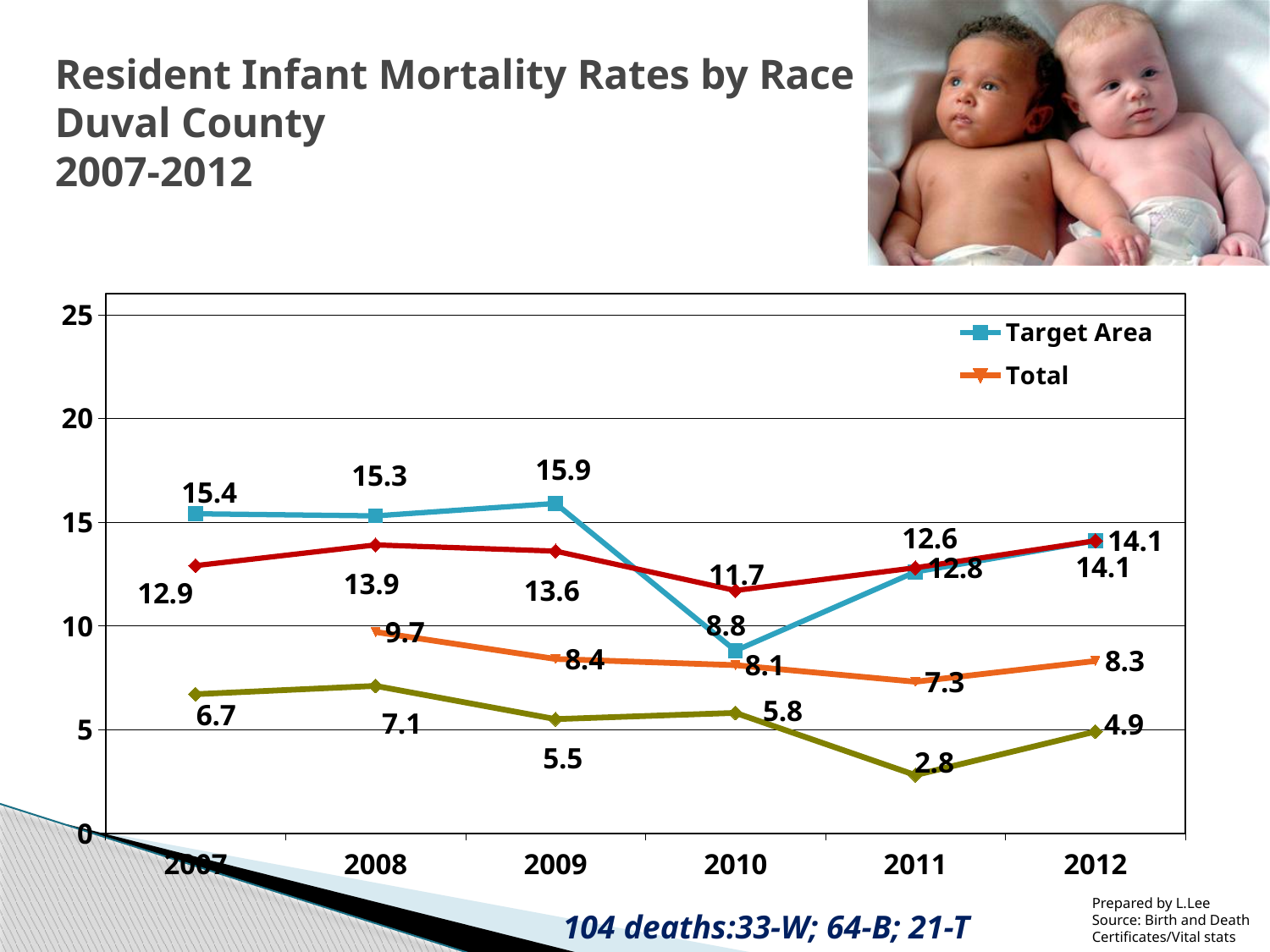
What is the Target Area infant mortality rate in 2010? 8.8 In which year is the Target Area rate lowest? 2010 How many series does the chart legend list? 2 What is the Total infant mortality rate in 2012? 8.3 How many years are shown along the x axis of the chart? 6 In 2012, which is larger, the Target Area rate or the Total rate? Target Area In which year is the Target Area rate highest? 2009 What is the Target Area infant mortality rate in 2009? 15.9 Does the Total rate rise or fall from 2008 to 2011? fall What is the difference between the Target Area rate in 2009 and in 2010? 7.1 What kind of chart is shown on the slide? line chart What is the Total infant mortality rate in 2011? 7.3